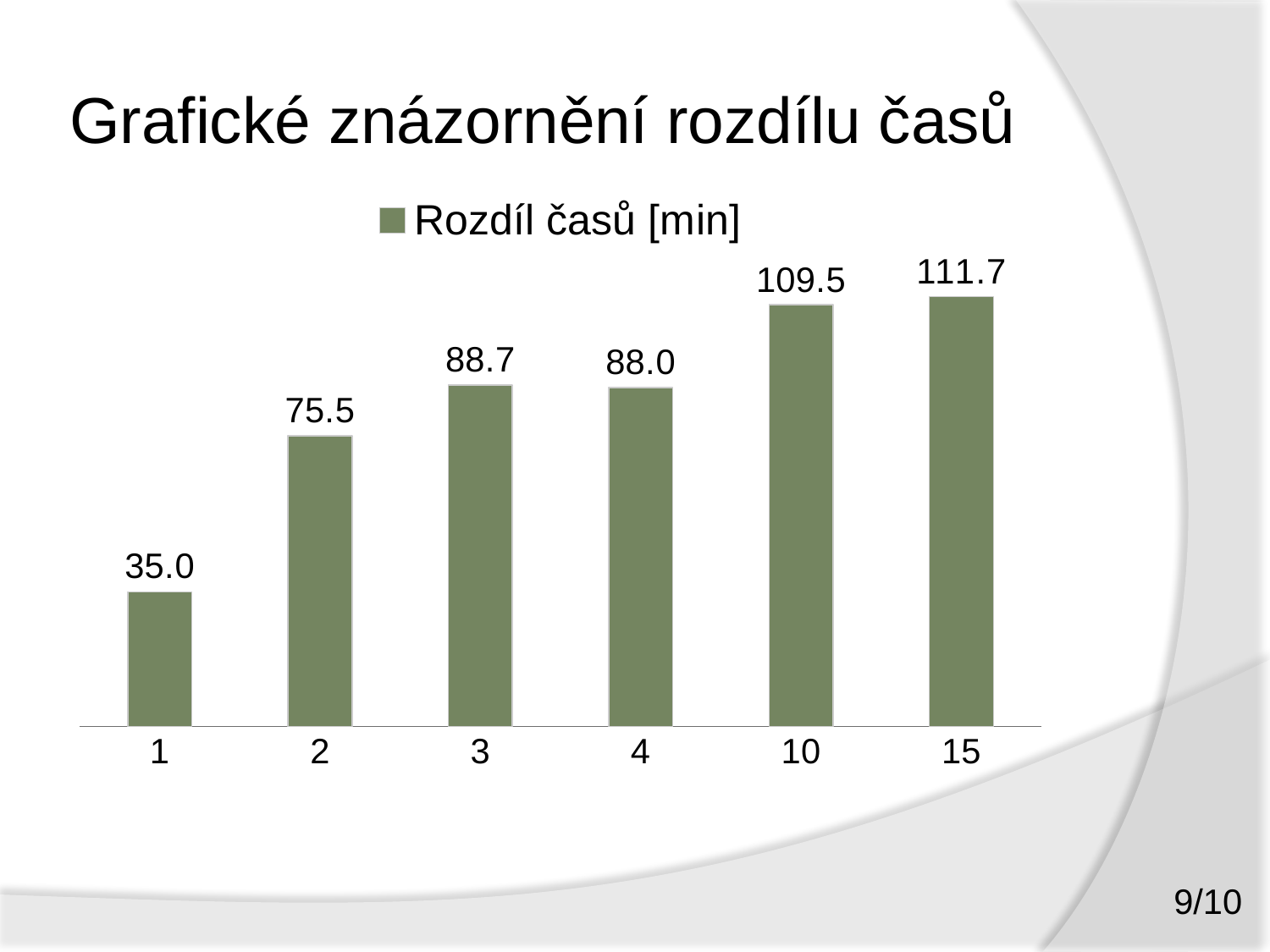
What is the value for category 10? 109.5 Which is larger, the value for category 2 or the value for category 4? 4 What is the difference between the values for category 15 and category 1? 76.7 What is the value for category 1? 35.0 How many series does the legend list? 1 What is the difference between the values for category 2 and category 1? 40.5 What is the legend entry for the series? Rozdíl časů [min] Which category has the lowest value? 1 What is the value for category 3? 88.7 Which category has the highest value? 15 How many categories are shown on the x axis? 6 What kind of chart is shown on the slide? bar chart